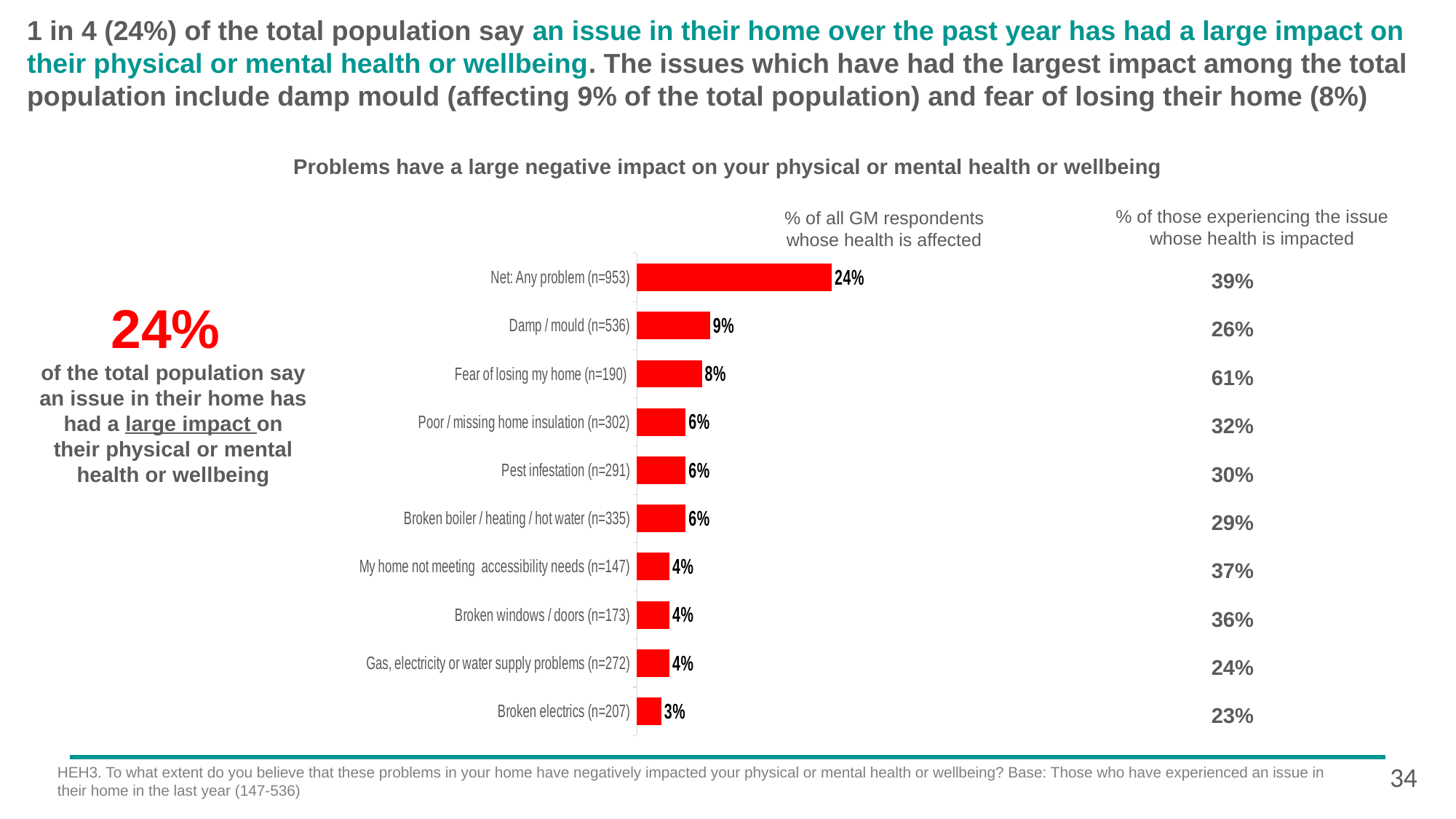
What kind of chart is shown on the slide? Bar chart What colour are the bars in the chart? Red Which category has the highest value in the bar chart? Net: Any problem (n=953) Which is larger: the value for Fear of losing my home (n=190) or the value for Pest infestation (n=291)? Fear of losing my home (n=190) What is the value for Net: Any problem (n=953) in the bar chart? 24% How many categories are shown in the bar chart? 10 What is the difference between the values for Damp / mould (n=536) and Broken electrics (n=207)? 6% What is the title of the chart? Problems have a large negative impact on your physical or mental health or wellbeing What is the value for Damp / mould (n=536) in the bar chart? 9% What is the value for Fear of losing my home (n=190) in the bar chart? 8% Which category has the lowest value in the bar chart? Broken electrics (n=207) What is the value for Broken electrics (n=207) in the bar chart? 3%